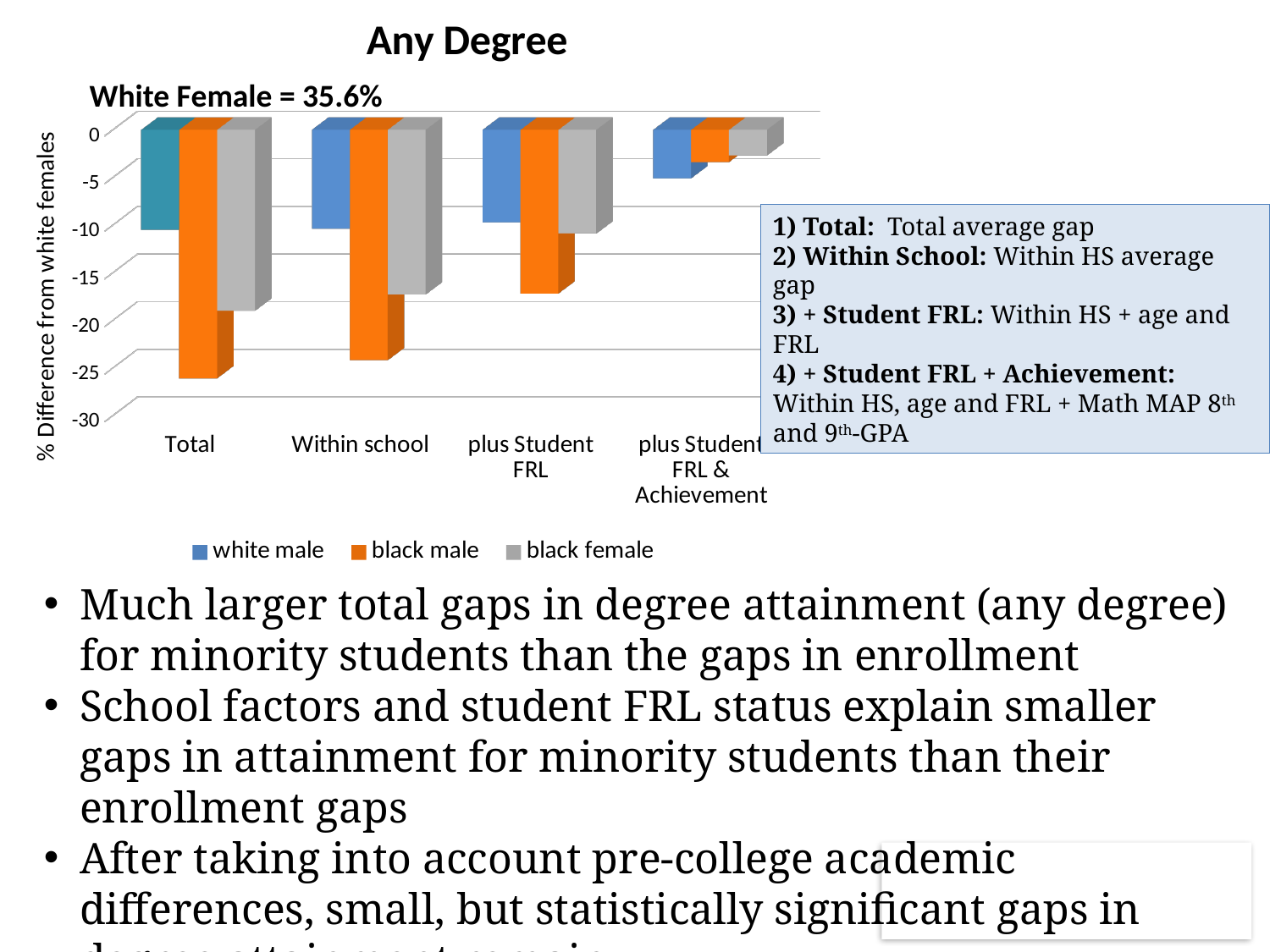
Is the value for black male in the Total category greater or less than -20? less In the Total category, which is more negative: black male or black female? black male How many categories are shown along the x axis? 4 Is the value for black female in the Within school category greater or less than -10? less How many series does the legend list? 3 Is the value for white male in the plus Student FRL & Achievement category greater or less than -10? greater In which category is the black male value closest to zero? plus Student FRL & Achievement What type of chart is shown on the slide? bar chart What value is stated for White Female above the chart? 35.6% In the Total category, which series has the lowest (most negative) value? black male Do the black male values rise or fall (move toward zero or away from it) from Total to plus Student FRL & Achievement? rise What is the title of the chart? Any Degree